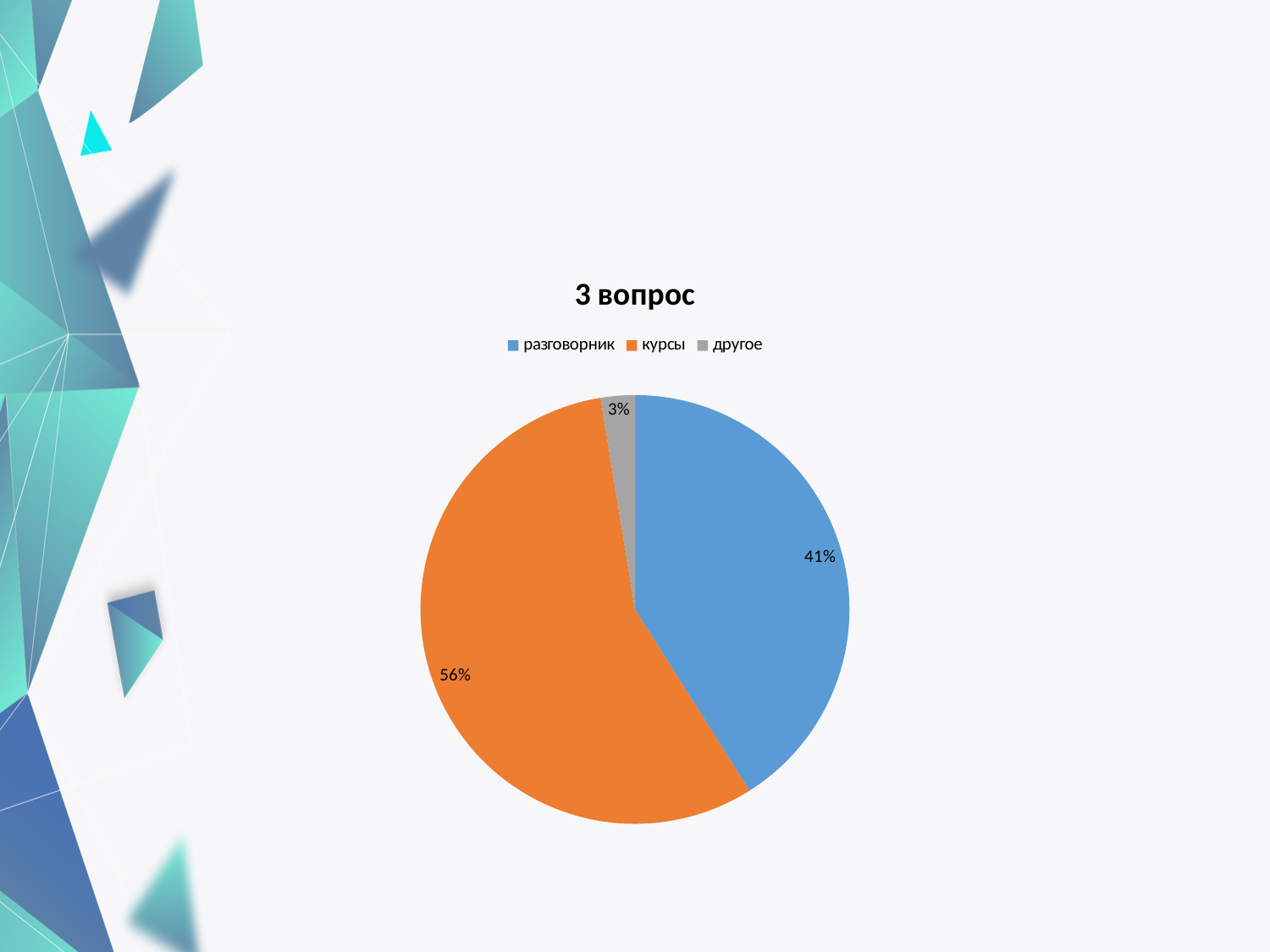
How many entries does the legend list? 3 Which is larger, the slice for разговорник or the slice for курсы? курсы What colour is the slice for курсы? orange What kind of chart is shown on the slide? pie chart How many categories does the pie chart have? 3 What is the difference in percentage points between курсы and разговорник? 15 What share of the pie does другое have? 3% What is the title of the chart? 3 вопрос What share of the pie does разговорник have? 41% Which category has the largest slice of the pie? курсы Which category has the smallest slice of the pie? другое What share of the pie does курсы have? 56%